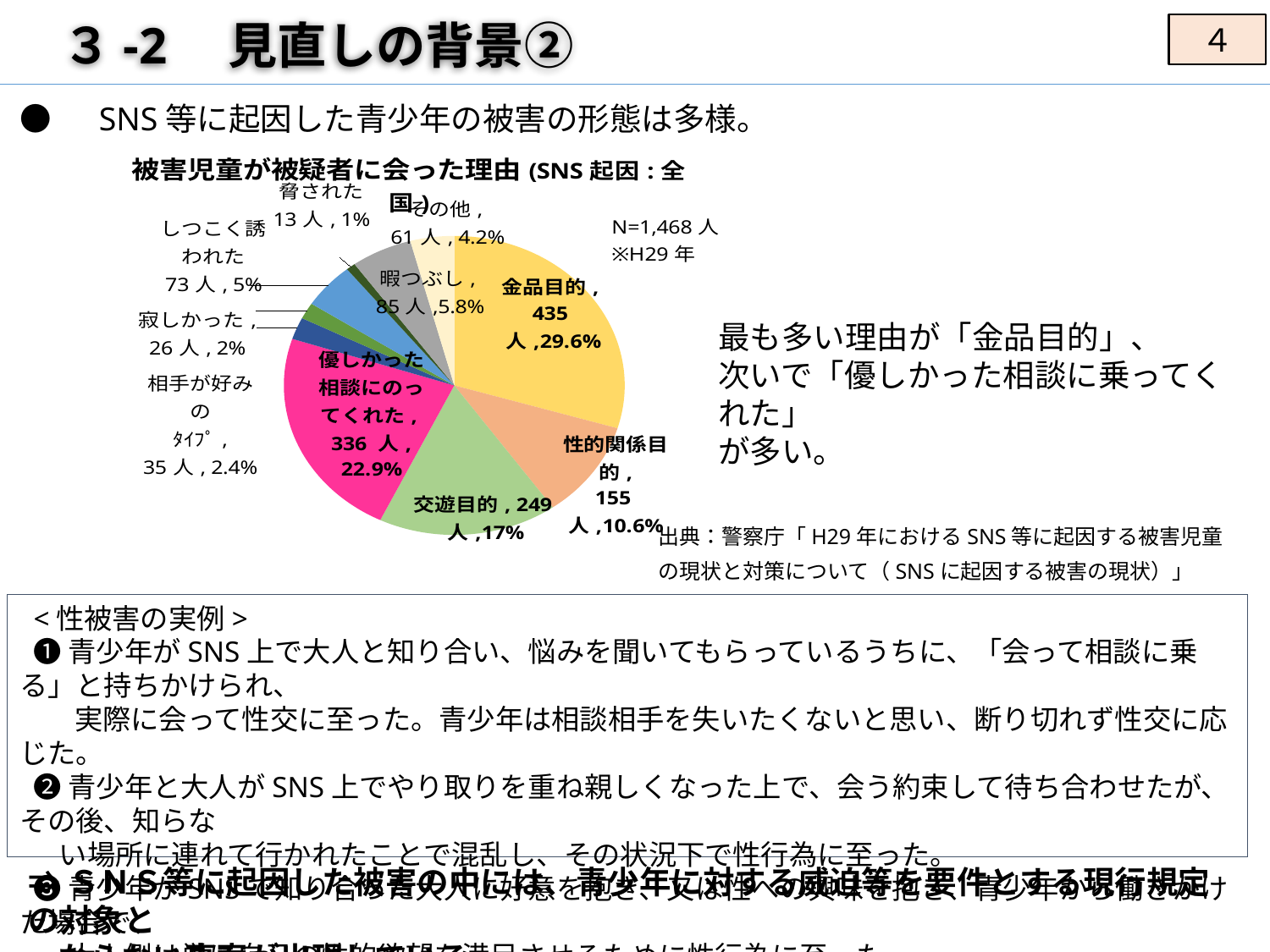
Which is larger, 暇つぶし or しつこく誘われた? 暇つぶし What is the N value shown for the pie chart? N=1,468人 Which category has the largest slice in the pie chart? 金品目的 What percentage does 性的関係目的 represent in the pie chart? 10.6% How many people are in the 寂しかった category? 26人 What is the difference in number of people between 金品目的 and 優しかった相談にのってくれた? 99人 How many people are in the 金品目的 slice of the pie chart? 435人 How many people are in the 交遊目的 category? 249人 How many categories are shown in the pie chart? 10 What percentage of the pie chart does 優しかった相談にのってくれた account for? 22.9% What kind of chart is shown on the slide? pie chart Which category has the smallest slice in the pie chart? 脅された